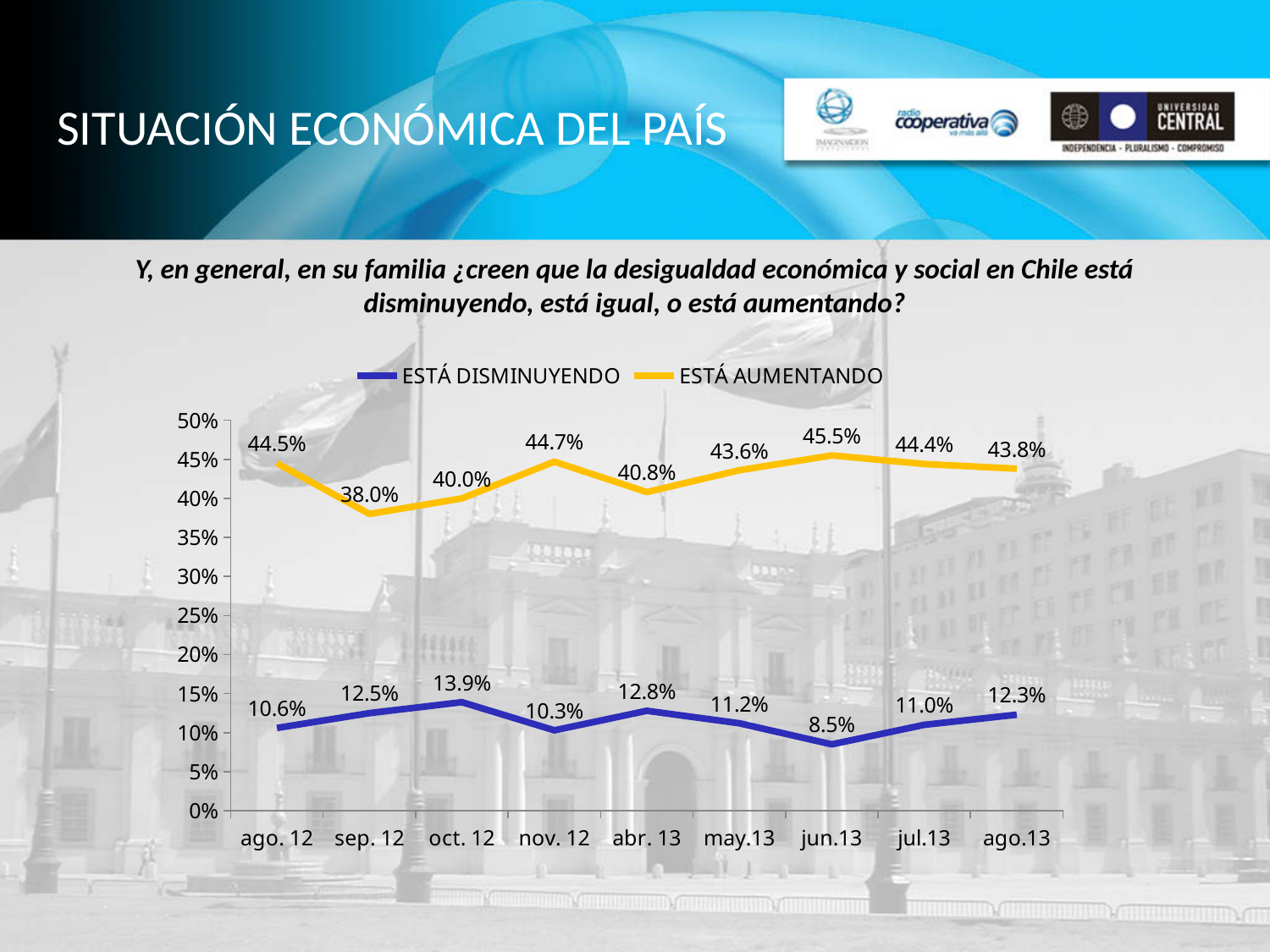
What is the difference between the ESTÁ AUMENTANDO and ESTÁ DISMINUYENDO values for ago.13? 31.5% Is the ESTÁ AUMENTANDO value for sep. 12 greater or less than 40%? less How many series does the legend list? 2 What kind of chart is shown on the slide? line chart How many months are shown on the x axis? 9 In which month does the ESTÁ DISMINUYENDO series reach its highest value? oct. 12 What value does the ESTÁ DISMINUYENDO series show for oct. 12? 13.9% Which is larger for nov. 12: the ESTÁ AUMENTANDO value or the ESTÁ DISMINUYENDO value? ESTÁ AUMENTANDO In which month does the ESTÁ AUMENTANDO series reach its lowest value? sep. 12 What colour is the line for ESTÁ AUMENTANDO? yellow What value does the ESTÁ AUMENTANDO series show for jun.13? 45.5% What value does the ESTÁ DISMINUYENDO series show for jun.13? 8.5%